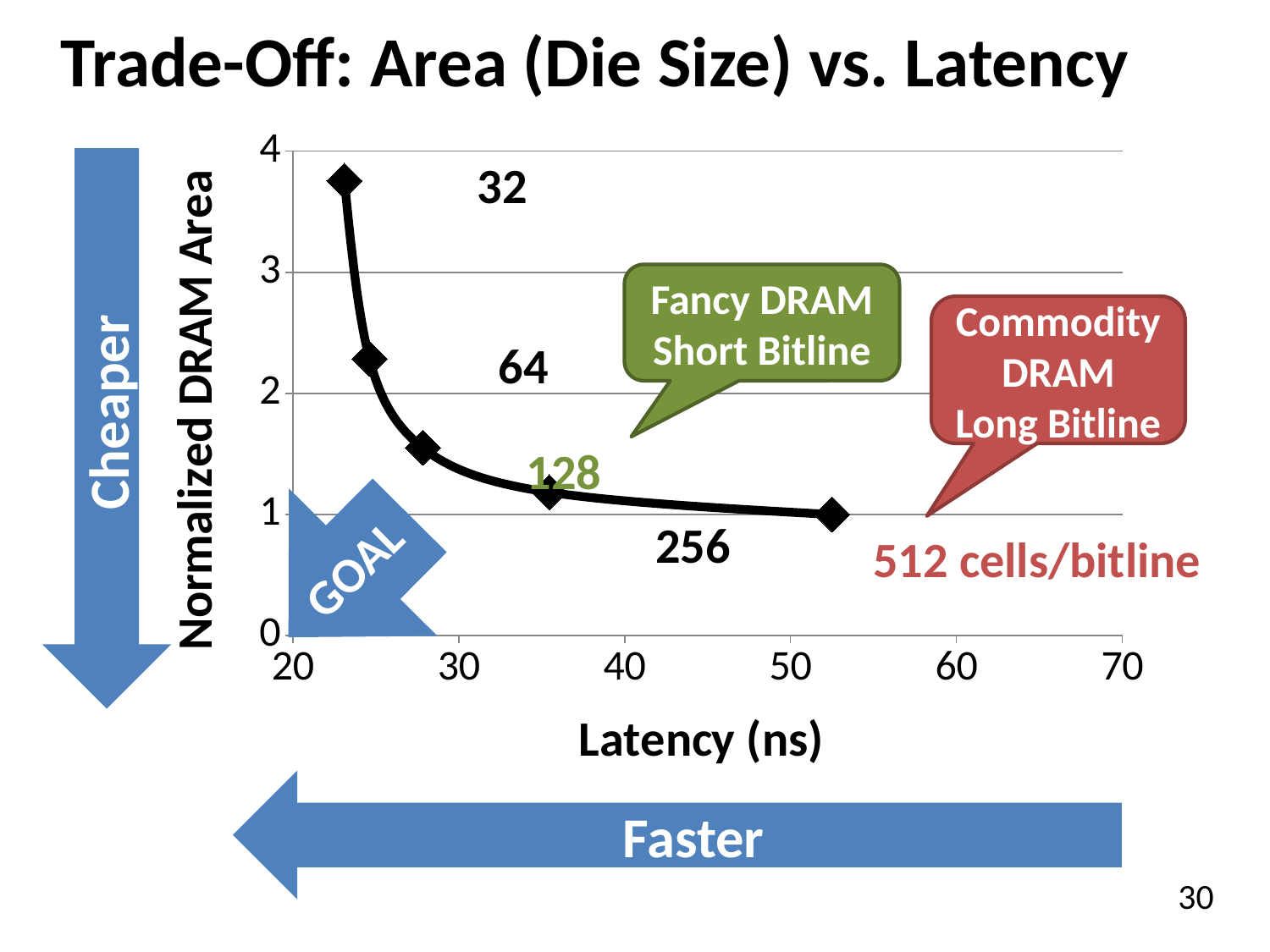
Is the latency for 32 cells/bitline greater or less than 30 ns? less Is the normalized DRAM area for 64 cells/bitline greater or less than 2? greater What is the label of the x axis? Latency (ns) Which cells/bitline configuration has the lowest normalized DRAM area? 512 Which cells/bitline configuration has the highest normalized DRAM area? 32 Is the latency for 512 cells/bitline greater or less than 40 ns? greater Which has a larger normalized DRAM area, 32 cells/bitline or 128 cells/bitline? 32 cells/bitline How many data points are plotted on the curve? 5 What is the normalized DRAM area for 512 cells/bitline? 1 As latency increases along the x axis, does the normalized DRAM area rise or fall? fall What is the title of the chart on the slide? Trade-Off: Area (Die Size) vs. Latency